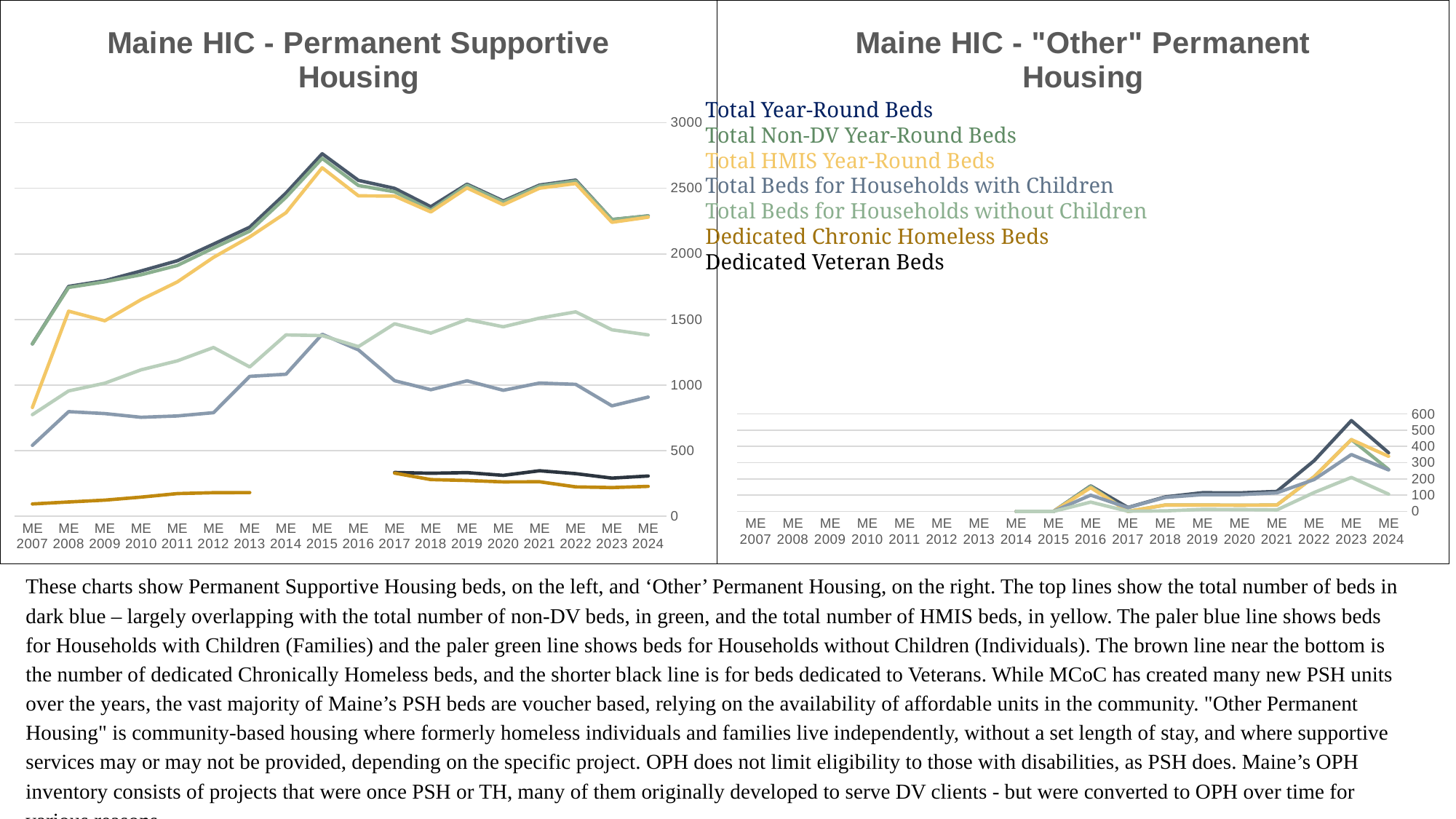
In the "Maine HIC - "Other" Permanent Housing" chart, in which year is Total Year-Round Beds highest? ME 2023 In the "Maine HIC - "Other" Permanent Housing" chart, is the value of Total Year-Round Beds in ME 2023 greater or less than 500? greater What kind of chart is the "Maine HIC - Permanent Supportive Housing" chart on the left? Line chart In the "Maine HIC - Permanent Supportive Housing" chart, is the value of Total Year-Round Beds in ME 2015 greater or less than 2500? greater In the "Maine HIC - Permanent Supportive Housing" chart, is the value of Dedicated Chronic Homeless Beds in ME 2013 greater or less than 500? less What colour is the Total HMIS Year-Round Beds line in the legend? Yellow How many series does the legend list? 7 How many years are shown on the x axis of the "Maine HIC - Permanent Supportive Housing" chart? 18 In the "Maine HIC - Permanent Supportive Housing" chart, which is larger in ME 2024: Total Beds for Households with Children or Total Beds for Households without Children? Total Beds for Households without Children In the "Maine HIC - Permanent Supportive Housing" chart, does Total Year-Round Beds rise or fall from ME 2007 to ME 2015? Rise In the "Maine HIC - Permanent Supportive Housing" chart, in which year is Total Year-Round Beds highest? ME 2015